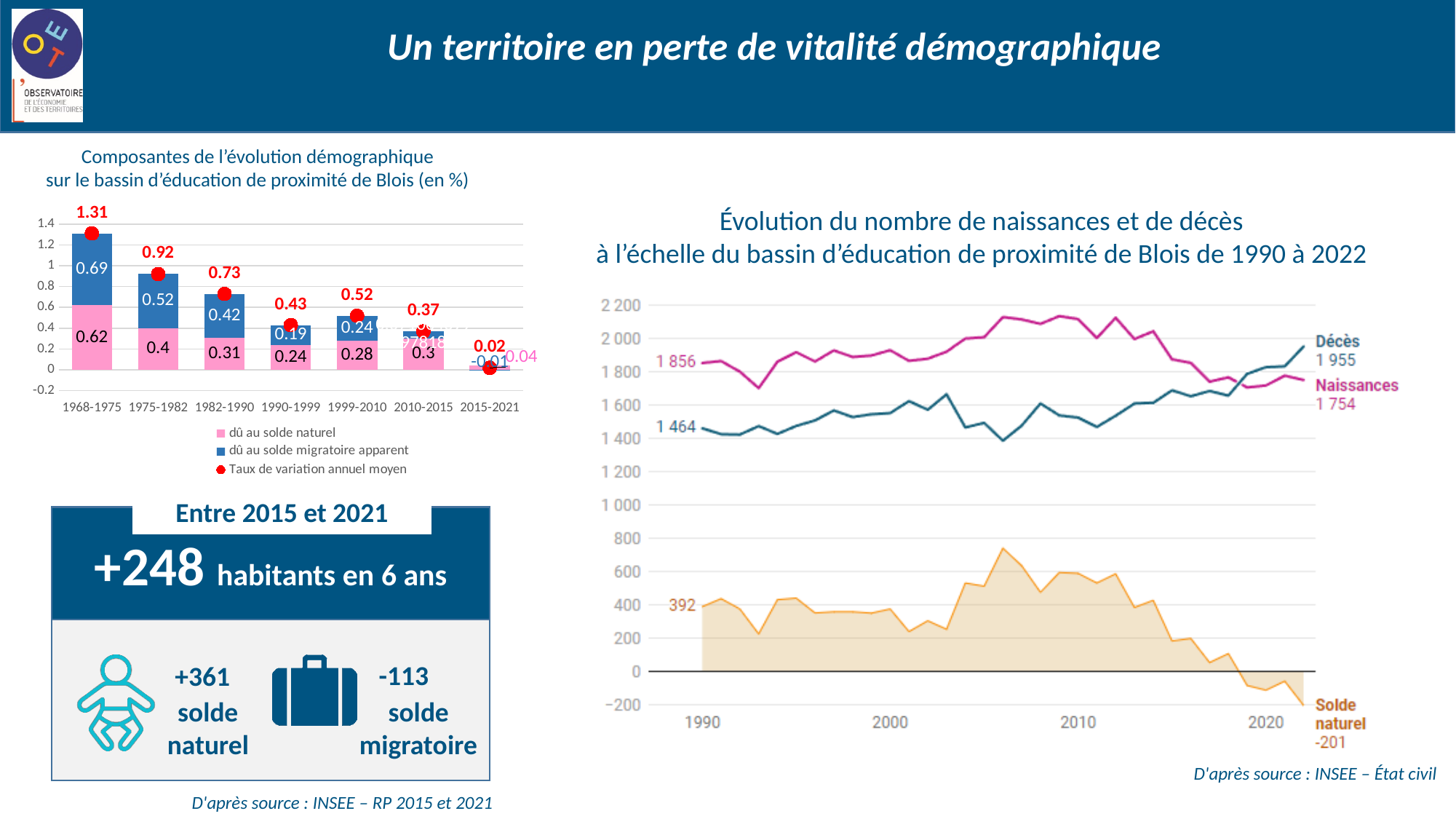
In the left chart, which period has the lowest 'Taux de variation annuel moyen'? 2015-2021 How many periods are shown on the x axis of the left chart? 7 In the left chart, what is the value 'dû au solde naturel' for 1968-1975? 0.62 In the right chart, which is larger in 2022, 'Décès' or 'Naissances'? Décès What kind of chart is the left chart titled 'Composantes de l'évolution démographique'? bar chart In the left chart, what is the difference between the 'Taux de variation annuel moyen' for 1968-1975 and for 1975-1982? 0.39 In the right chart, does the 'Solde naturel' rise or fall between 2010 and 2022? fall In the right chart, what is the number of 'Naissances' in 1990? 1 856 In the left chart, what is the 'Taux de variation annuel moyen' for 1975-1982? 0.92 How many series does the legend of the left chart list? 3 In the left chart, which period has the highest 'Taux de variation annuel moyen'? 1968-1975 In the right chart, what is the number of 'Décès' in 2022? 1 955